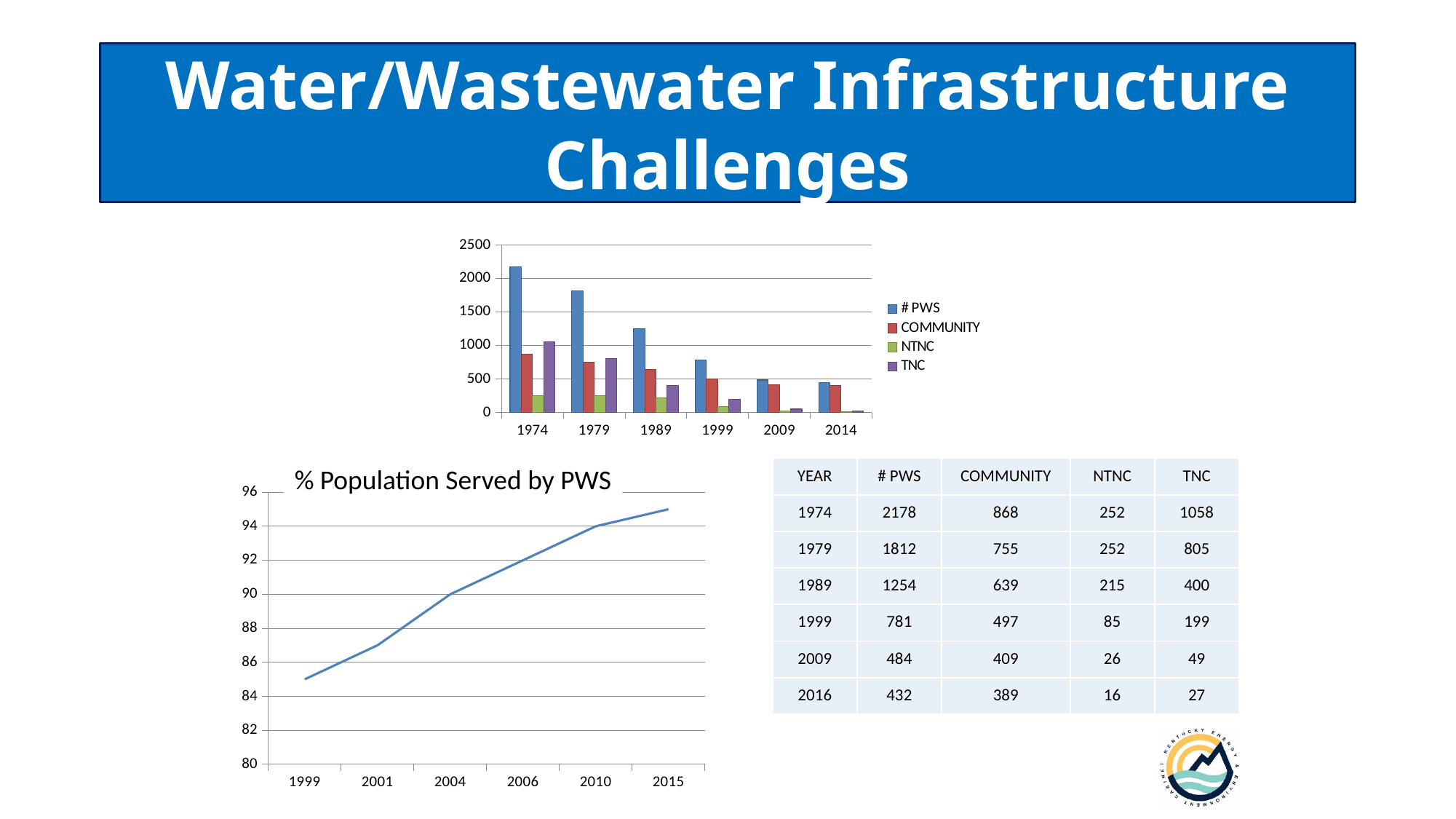
In the top bar chart, do the # PWS values rise or fall from 1974 to 2014? fall What kind of chart is '% Population Served by PWS'? line chart In the top bar chart, which year has the highest # PWS value? 1974 In the top bar chart, which is larger for 1979: COMMUNITY or TNC? TNC In the '% Population Served by PWS' chart, what is the value for 2004? 90 What kind of chart is the top chart on the slide? bar chart In the '% Population Served by PWS' chart, do the values rise or fall from 1999 to 2015? rise How many series does the legend of the top bar chart list? 4 How many years are shown on the x axis of the '% Population Served by PWS' chart? 6 How many years are shown on the x axis of the top bar chart? 6 In the top bar chart, is the # PWS value for 1974 greater or less than 2000? greater